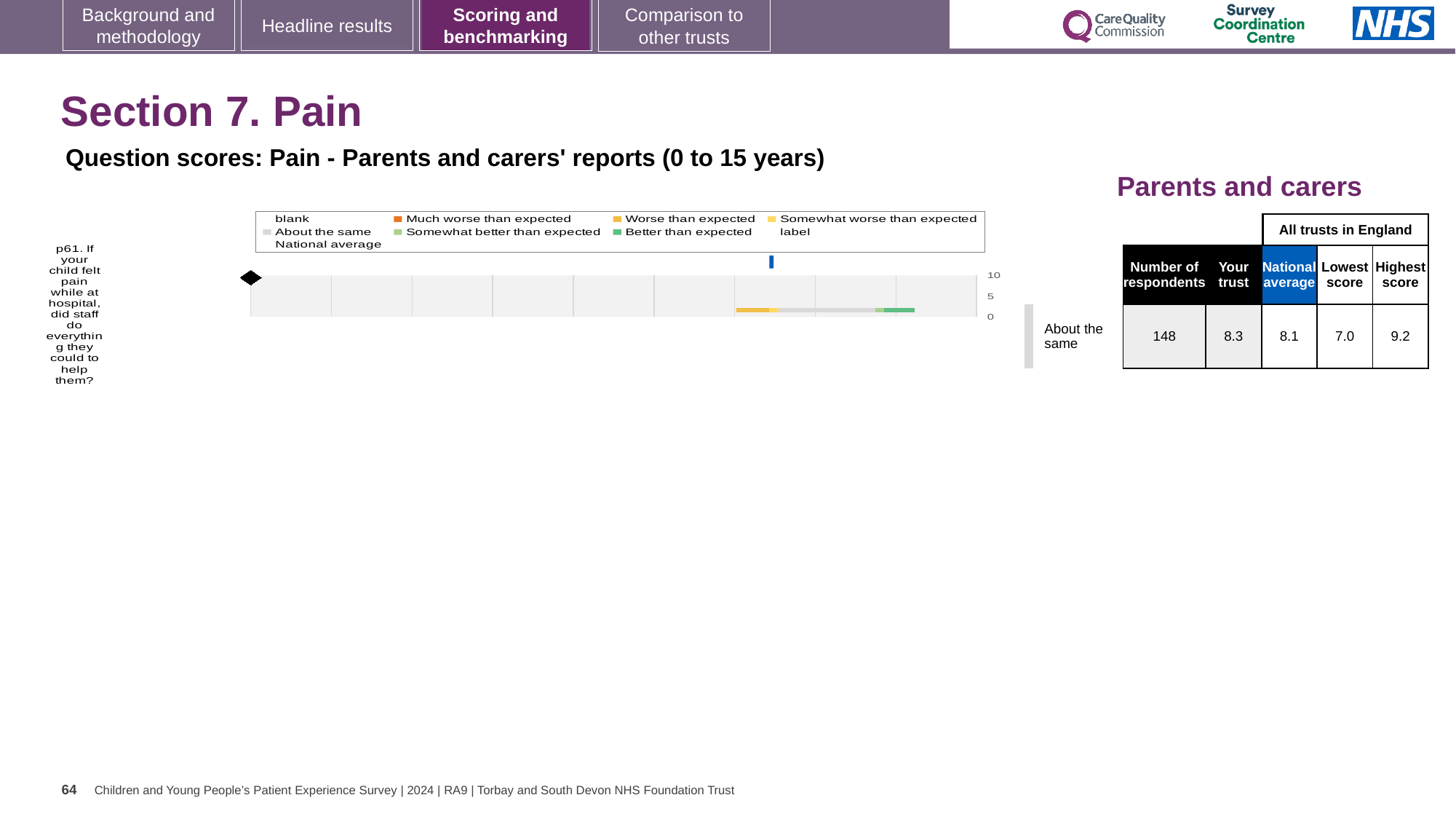
According to the table beside the chart, which is larger: the 'Your trust' score or the national average? Your trust What is the highest value shown on the chart's axis? 10 According to the table beside the chart, what is the difference between the highest score and the lowest score among all trusts in England? 2.2 How many survey questions are plotted in the chart? 1 What kind of chart is shown on the slide? bar chart Which legend entry is shown in orange? Much worse than expected According to the table beside the chart, how many respondents answered the question? 148 Is the national average marker on the chart greater or less than 5? greater According to the table beside the chart, what is the 'Your trust' score for the 'About the same' row? 8.3 According to the table beside the chart, what is the highest score among all trusts in England? 9.2 According to the table beside the chart, what is the national average score? 8.1 According to the table beside the chart, what is the lowest score among all trusts in England? 7.0